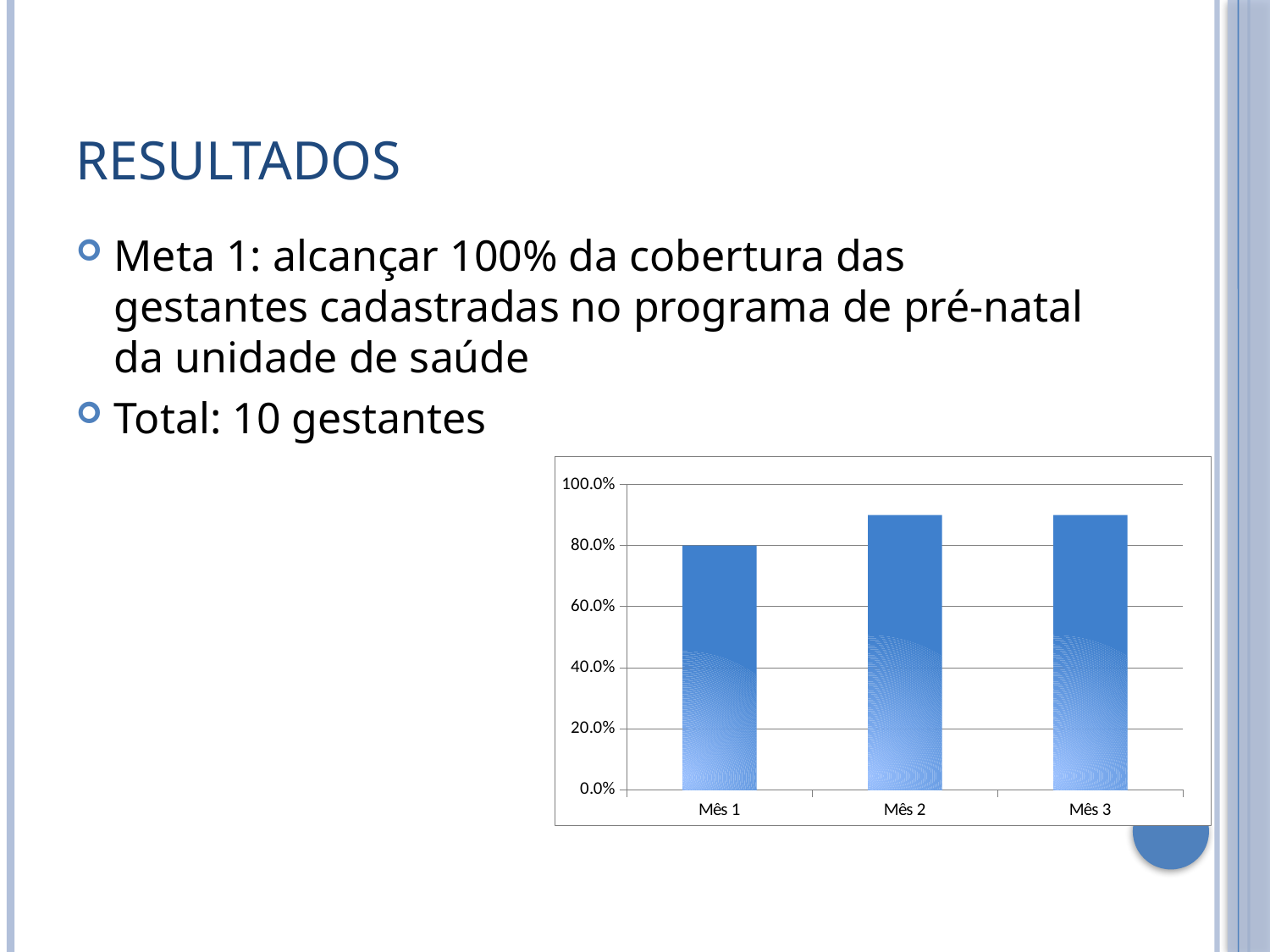
Is the value for Mês 3 greater or less than 100.0%? less Is the value for Mês 1 greater or less than 60.0%? greater Which category has the lowest value in the chart? Mês 1 What colour are the bars in the chart? blue How many categories are shown on the x axis of the chart? 3 Is the value for Mês 2 greater or less than 80.0%? greater Which is larger in the chart, the value for Mês 1 or the value for Mês 2? Mês 2 What kind of chart is shown on the slide? bar chart What is the highest value labelled on the vertical axis of the chart? 100.0% What is the value for Mês 1 in the chart? 80.0% Does the value rise or fall from Mês 1 to Mês 2? rise Which is larger in the chart, the value for Mês 3 or the value for Mês 1? Mês 3